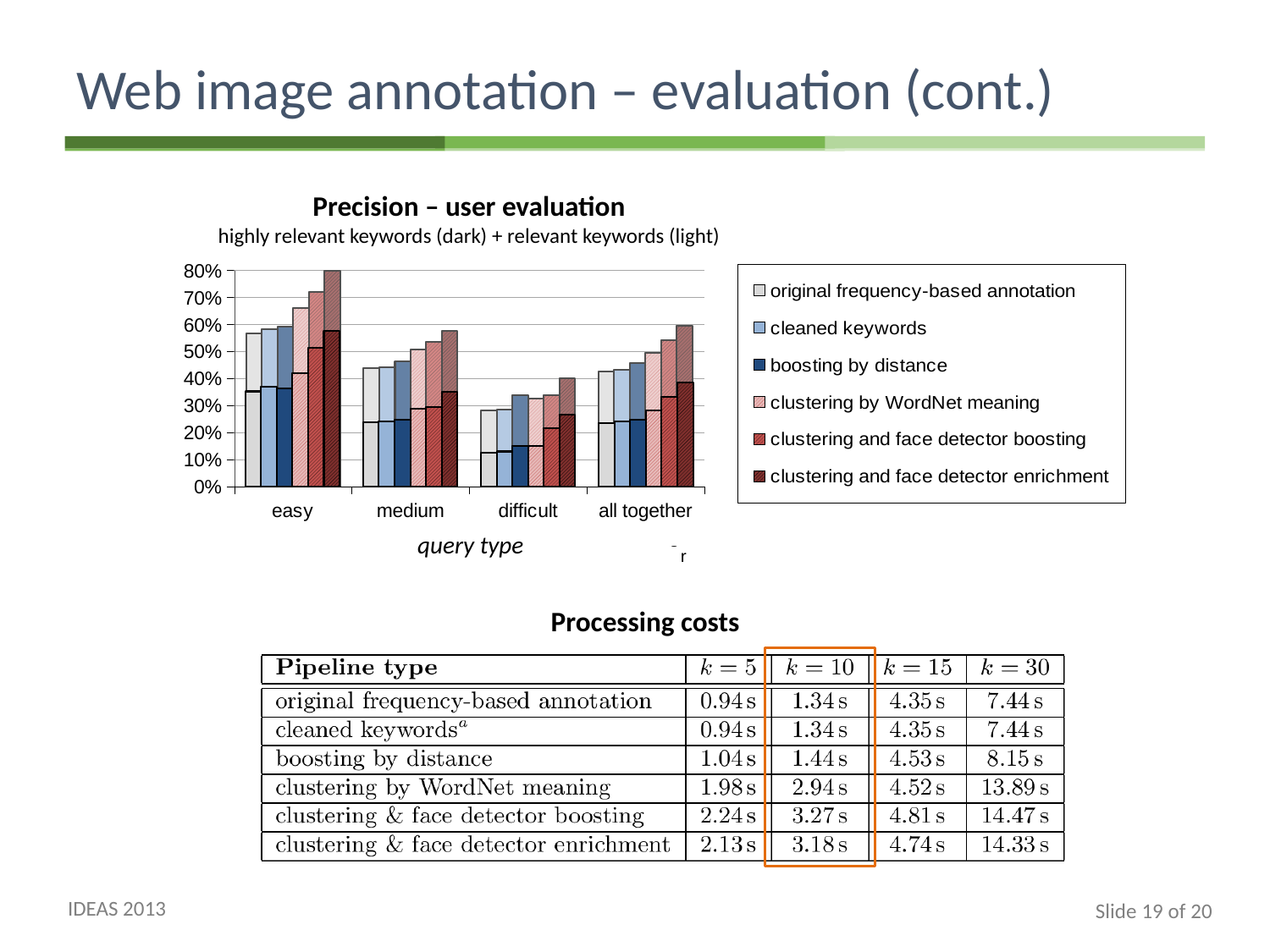
For which query type are the precision bars lowest overall? difficult How many series does the chart's legend list? 6 What kind of chart is shown on the slide? bar chart What is the title of the chart's x axis? query type How many query types are shown on the x axis of the chart? 4 Going from easy to medium to difficult queries, do the precision values rise or fall? fall Is the value for clustering and face detector enrichment on all together queries greater or less than 50%? greater Is the value for clustering and face detector enrichment on easy queries greater or less than 70%? greater Which series is listed last in the chart's legend? clustering and face detector enrichment Which is larger for clustering and face detector enrichment: the value for easy queries or for difficult queries? easy For which query type are the precision bars highest overall? easy Is the value for original frequency-based annotation on difficult queries greater or less than 40%? less